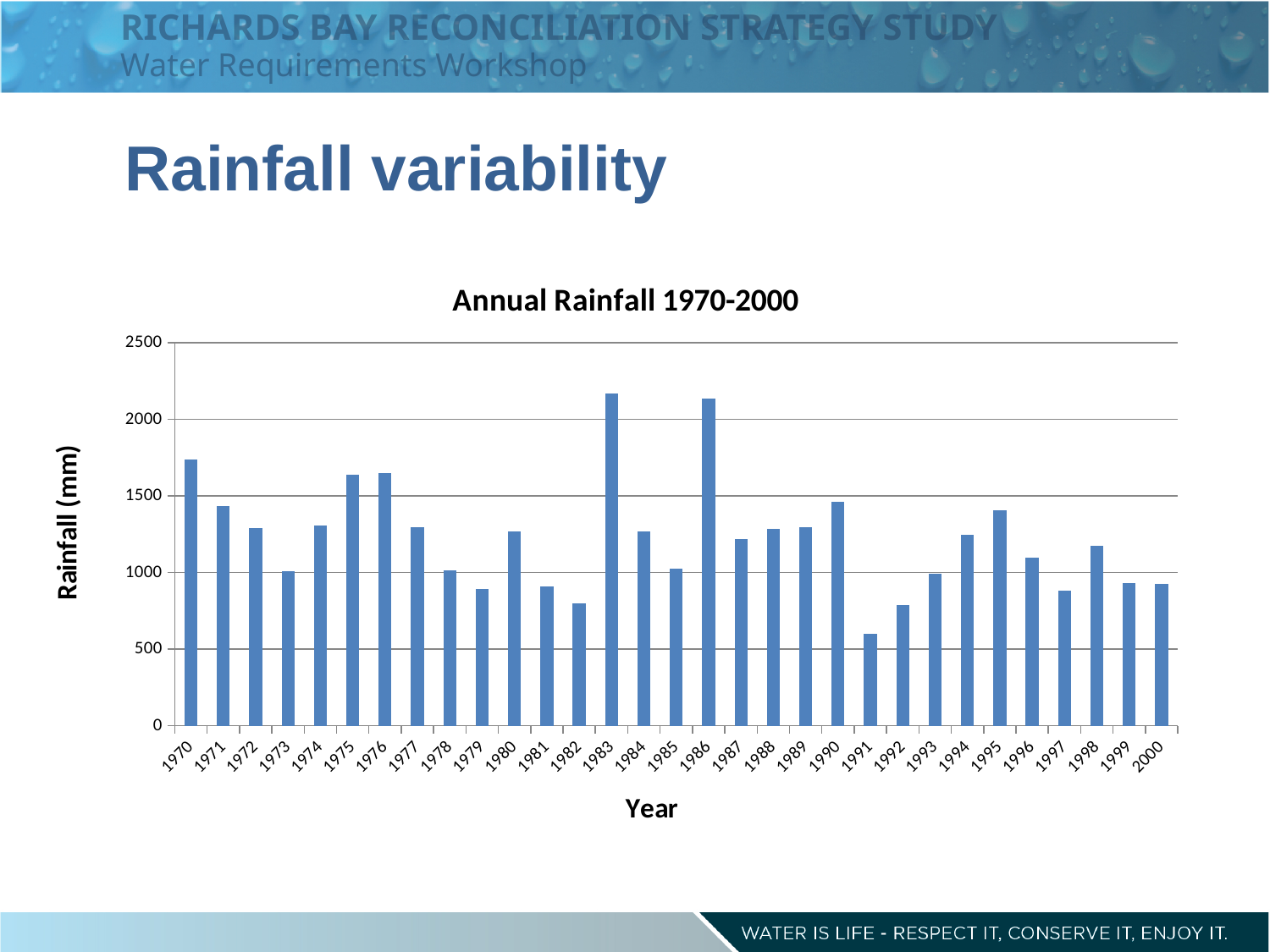
What is the title of the chart? Annual Rainfall 1970-2000 Is the rainfall value for 1982 greater or less than 1000? less Which year has the higher rainfall, 1991 or 1992? 1992 What is the label on the vertical axis of the chart? Rainfall (mm) Is the rainfall value for 1991 greater or less than 1000? less What kind of chart is shown on the slide? Bar chart Which year has the lowest annual rainfall? 1991 How many years are plotted on the chart? 31 Is the rainfall value for 1983 greater or less than 2000? greater Which year has the higher rainfall, 1995 or 1996? 1995 Which year has the higher rainfall, 1970 or 1971? 1970